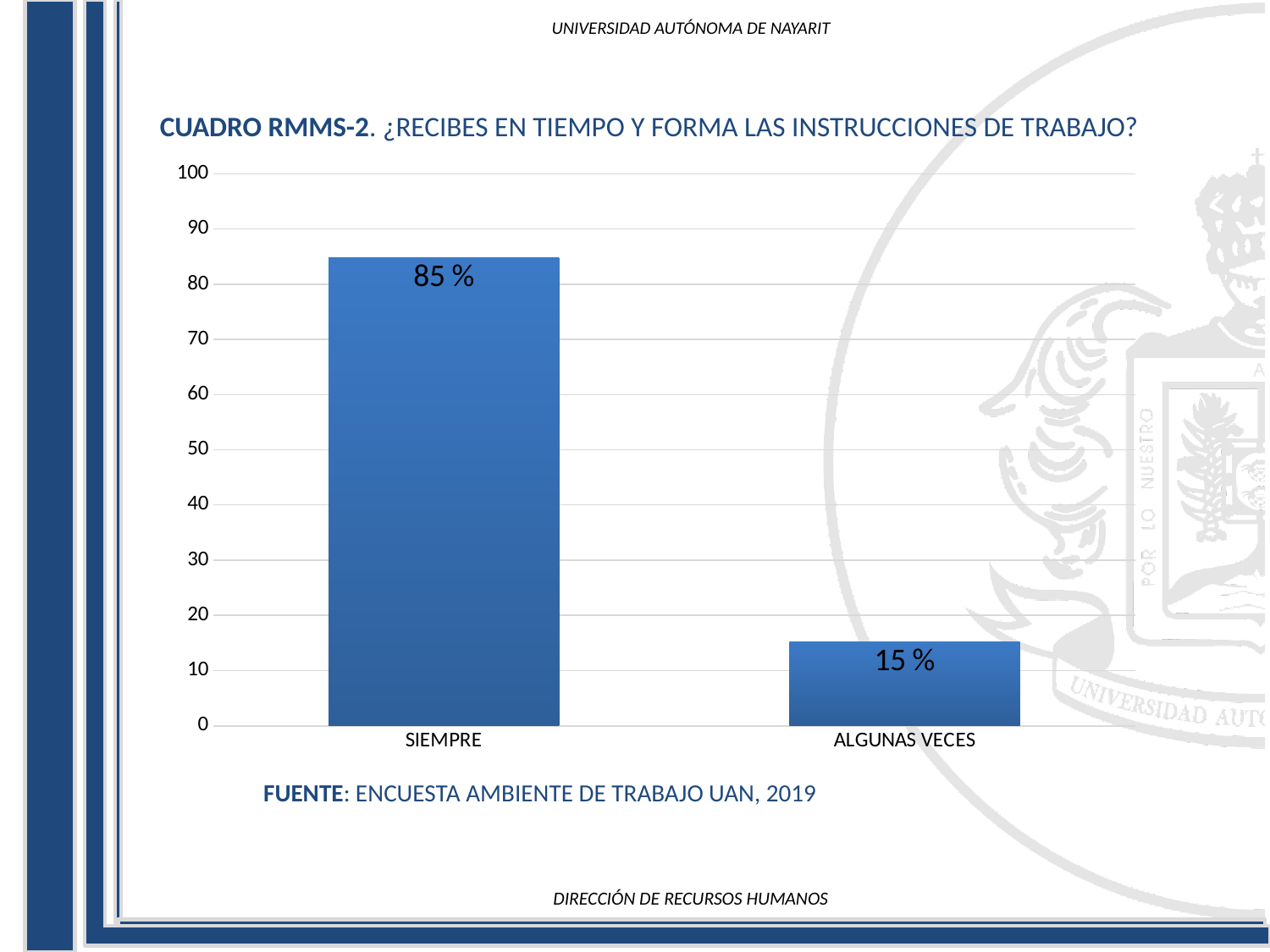
What is the value for SIEMPRE? 85 % What kind of chart is shown on the slide? bar chart What source is cited below the chart? ENCUESTA AMBIENTE DE TRABAJO UAN, 2019 Is the value for ALGUNAS VECES greater or less than 20? less Which is larger, the value for SIEMPRE or the value for ALGUNAS VECES? SIEMPRE What is the difference between the values for SIEMPRE and ALGUNAS VECES? 70 % Is the value for SIEMPRE greater or less than 80? greater What is the value for ALGUNAS VECES? 15 % What is the maximum value shown on the vertical axis? 100 Which category has the highest value? SIEMPRE Which category has the lowest value? ALGUNAS VECES How many categories are shown on the x axis? 2